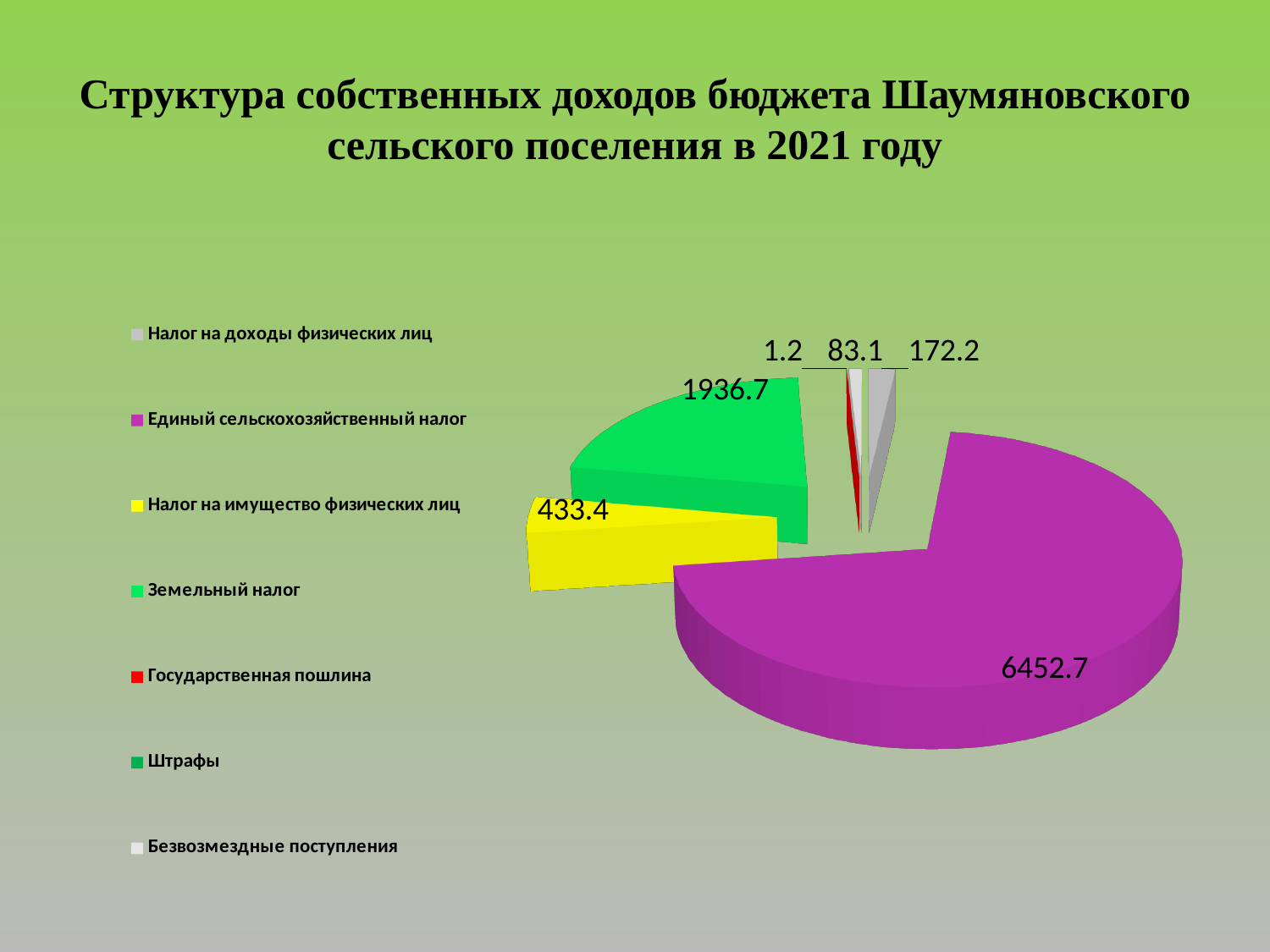
What is the difference between the values for Земельный налог and Налог на имущество физических лиц? 1503.3 Which is larger: the value for Земельный налог or the value for Единый сельскохозяйственный налог? Единый сельскохозяйственный налог What is the value for Налог на имущество физических лиц? 433.4 What is the difference between the values for Единый сельскохозяйственный налог and Земельный налог? 4516.0 Which is larger: the value for Налог на имущество физических лиц or the value for Налог на доходы физических лиц? Налог на имущество физических лиц What is the value for Земельный налог? 1936.7 Which category has the largest slice of the pie? Единый сельскохозяйственный налог What is the value for Единый сельскохозяйственный налог? 6452.7 What kind of chart is shown on the slide? pie chart What colour is the slice for Земельный налог? green How many categories does the legend list? 7 What is the value for Налог на доходы физических лиц? 172.2